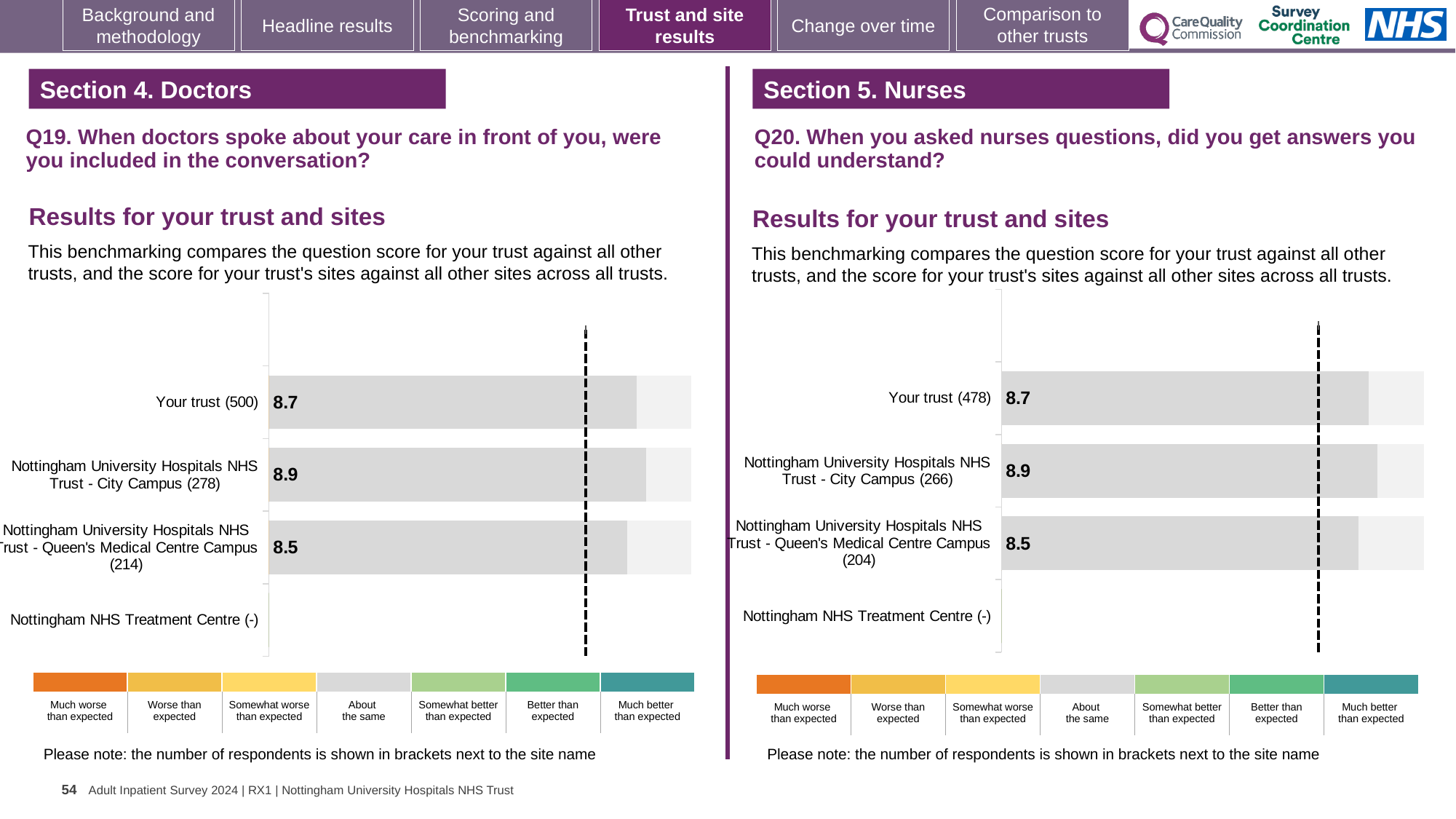
What kind of chart is the Q20 chart (right)? Bar chart On the Q19 chart (left), what is the difference between the City Campus score and the Queen's Medical Centre Campus score? 0.4 On the Q20 chart (right), which site has the lowest score among those with a value shown? Nottingham University Hospitals NHS Trust - Queen's Medical Centre Campus (204) How many categories are listed on the Q19 chart (left)? 4 On the Q19 chart (left), which site has the highest score? Nottingham University Hospitals NHS Trust - City Campus (278) On the Q20 chart (right), which is larger: the score for Your trust (478) or the score for City Campus (266)? City Campus (266) On the Q19 chart (left), what is the score for Nottingham University Hospitals NHS Trust - City Campus (278)? 8.9 On the Q20 chart (right), what is the score for Your trust (478)? 8.7 On the Q19 chart (left), what is the score for Your trust (500)? 8.7 On the Q19 chart (left), what is the score for Nottingham University Hospitals NHS Trust - Queen's Medical Centre Campus (214)? 8.5 On the Q20 chart (right), what is the score for Nottingham University Hospitals NHS Trust - Queen's Medical Centre Campus (204)? 8.5 On the Q20 chart (right), what is the difference between the Your trust score and the Queen's Medical Centre Campus score? 0.2